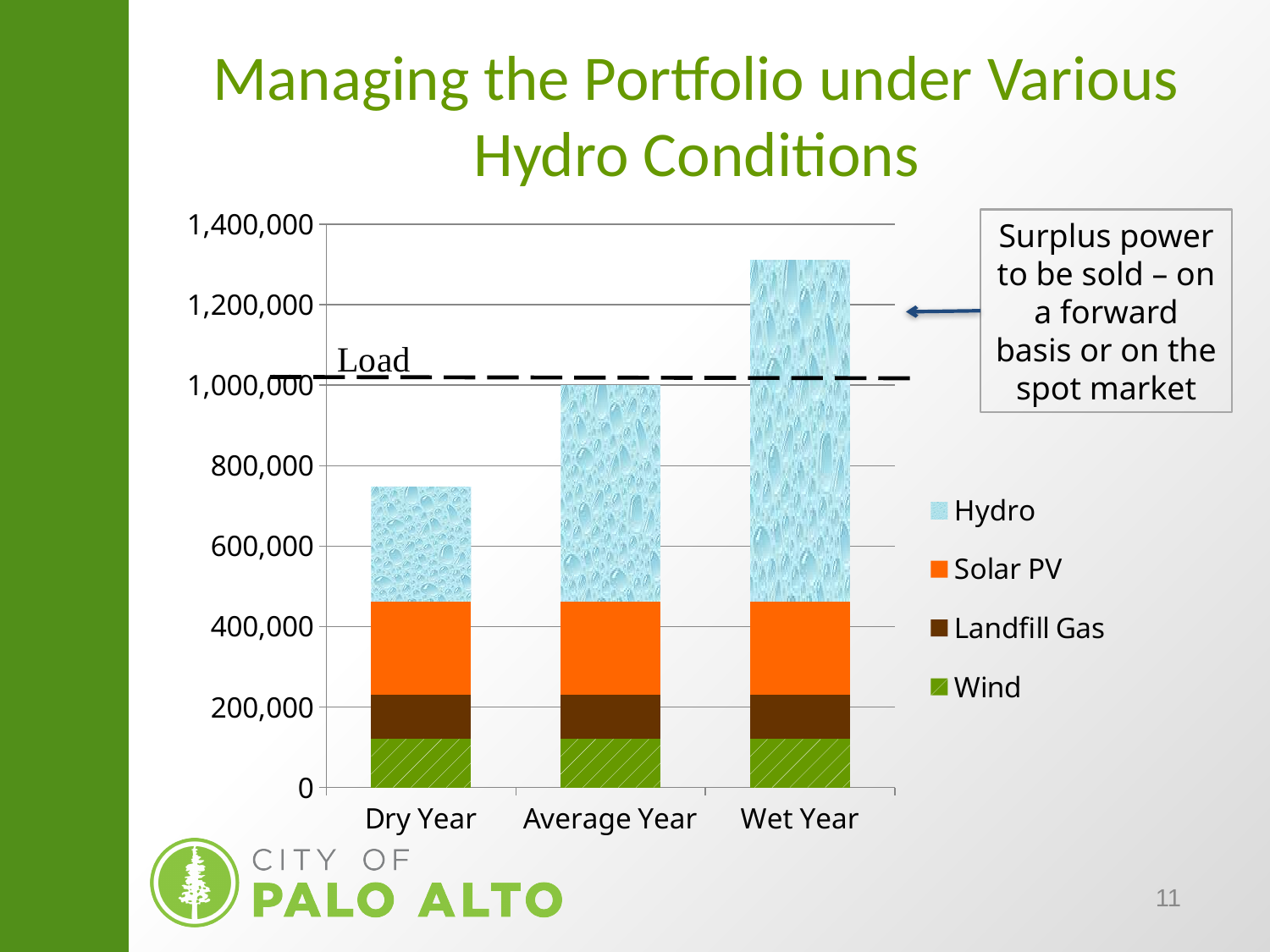
How many series does the chart's legend list? 4 Is the total for Wet Year greater or less than 1,200,000? greater Which category has the tallest stacked bar? Wet Year Is the Wind value for Dry Year greater or less than 200,000? less What kind of chart is shown on the slide? Stacked bar chart Do the stacked bar totals rise or fall moving from Dry Year to Wet Year? rise Is the total for Dry Year greater or less than 800,000? less What does the dashed horizontal line on the chart represent? Load Which is larger, the total for Average Year or the total for Dry Year? Average Year Which category has the shortest stacked bar? Dry Year How many categories are shown on the x axis of the chart? 3